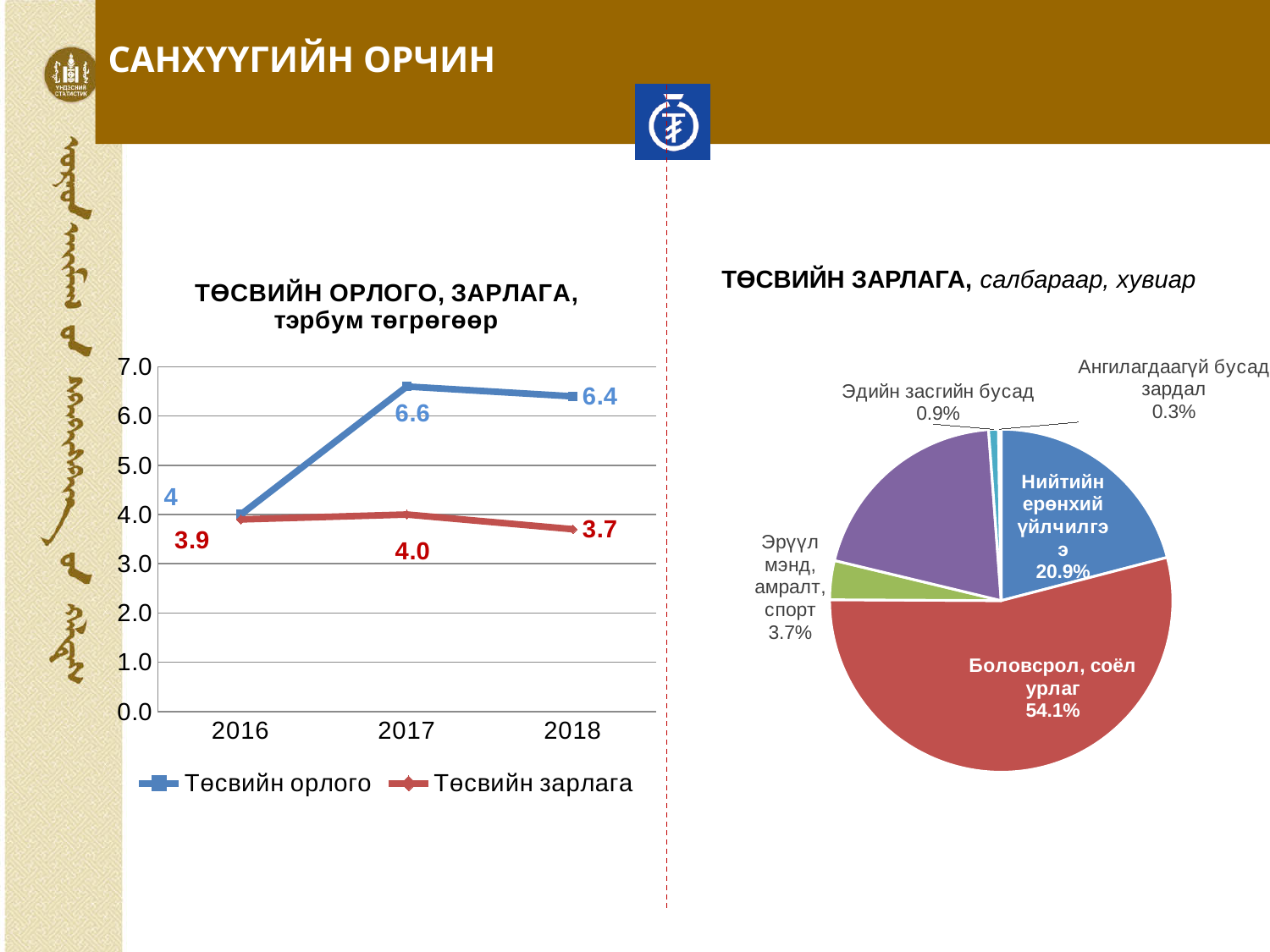
In the line chart 'ТӨСВИЙН ОРЛОГО, ЗАРЛАГА', in which year is Төсвийн зарлага lowest? 2018 In the line chart 'ТӨСВИЙН ОРЛОГО, ЗАРЛАГА', how many years are shown on the x axis? 3 What kind of chart is the chart on the left of the slide? Line chart In the line chart 'ТӨСВИЙН ОРЛОГО, ЗАРЛАГА', what is the difference between Төсвийн орлого and Төсвийн зарлага in 2017? 2.6 In the line chart 'ТӨСВИЙН ОРЛОГО, ЗАРЛАГА', what is the value of Төсвийн орлого in 2017? 6.6 In the line chart 'ТӨСВИЙН ОРЛОГО, ЗАРЛАГА', what is the value of Төсвийн зарлага in 2018? 3.7 In the line chart 'ТӨСВИЙН ОРЛОГО, ЗАРЛАГА', how many series does the legend list? 2 In the line chart 'ТӨСВИЙН ОРЛОГО, ЗАРЛАГА', in which year is Төсвийн орлого highest? 2017 In the pie chart 'ТӨСВИЙН ЗАРЛАГА, салбараар, хувиар', which labeled slice is the smallest? Ангилагдаагүй бусад зардал In the line chart 'ТӨСВИЙН ОРЛОГО, ЗАРЛАГА', which is larger in 2016: Төсвийн орлого or Төсвийн зарлага? Төсвийн орлого In the pie chart 'ТӨСВИЙН ЗАРЛАГА, салбараар, хувиар', what share does Боловсрол, соёл урлаг have? 54.1% In the pie chart 'ТӨСВИЙН ЗАРЛАГА, салбараар, хувиар', what share does Эрүүл мэнд, амралт, спорт have? 3.7%